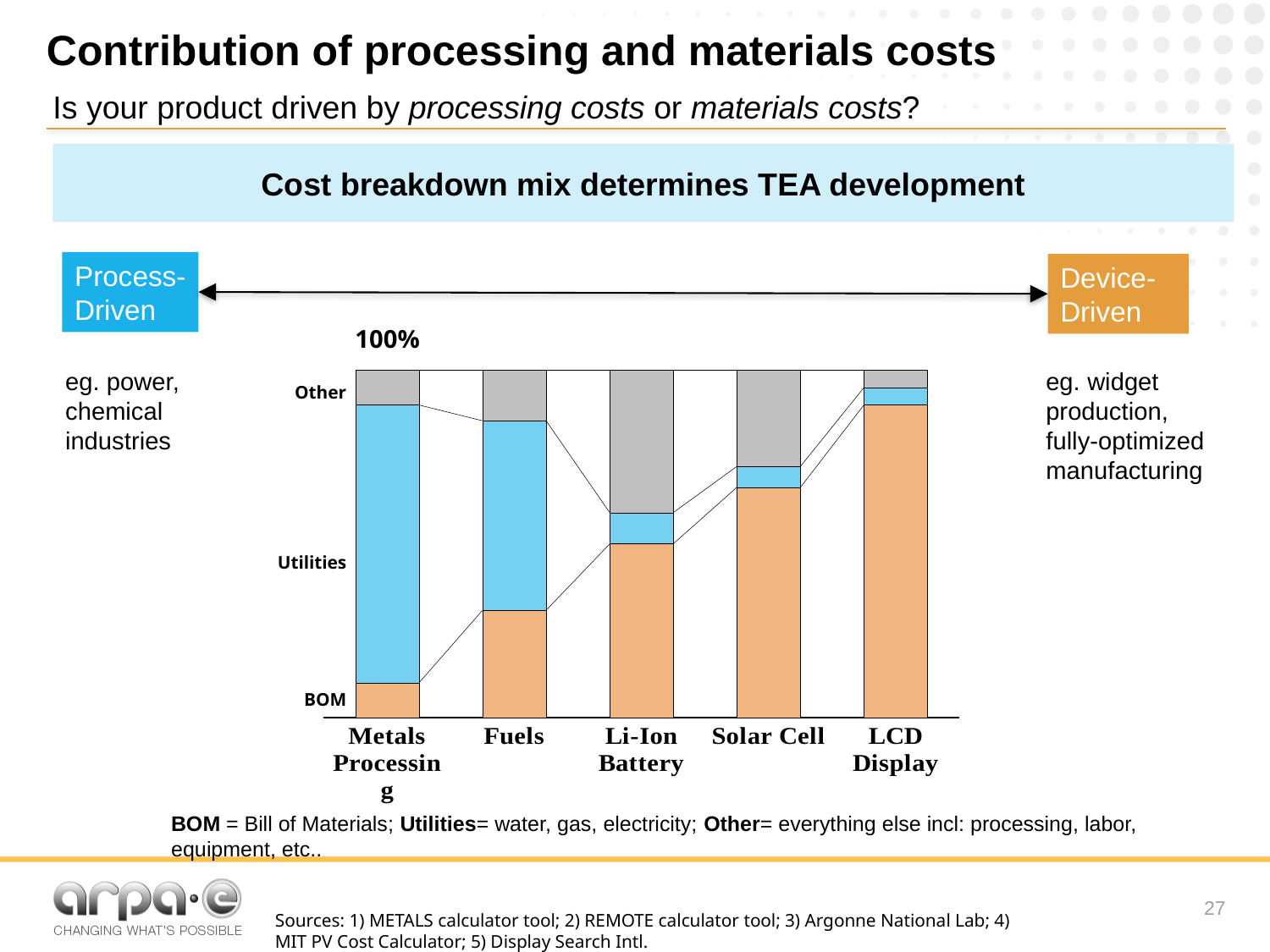
Does the BOM share rise or fall moving from Metals Processing to LCD Display along the x axis? Rise Which category has the smallest Other share in the chart? LCD Display Which category has the largest Utilities share in the chart? Metals Processing Which category has the largest Other share in the chart? Li-Ion Battery Which category has the smallest BOM share in the chart? Metals Processing Is the BOM share larger for Solar Cell or for Fuels? Solar Cell Is the Utilities share larger for Fuels or for Li-Ion Battery? Fuels What kind of chart is shown on the slide? Stacked bar chart What colour represents the Utilities component in the chart? Blue How many cost components (series) are stacked in each bar of the chart? 3 How many product categories are shown along the x axis of the chart? 5 Which category has the largest BOM share in the chart? LCD Display